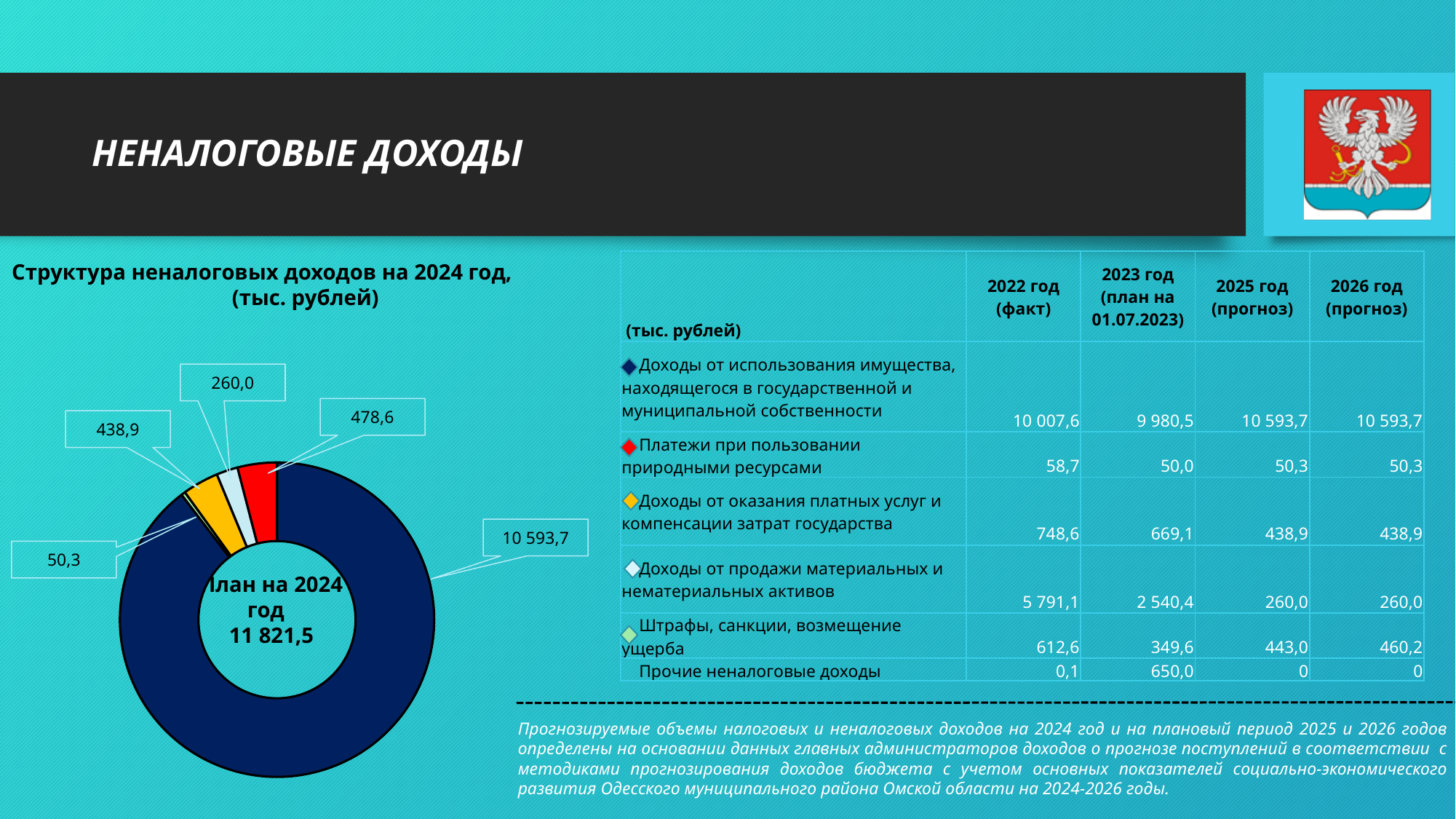
In the donut chart, what is the difference between the slices labelled 10 593,7 and 260,0? 10 333,7 In the donut chart, which is larger: the slice labelled 260,0 or the slice labelled 438,9? 438,9 What is the value of the largest slice in the donut chart? 10 593,7 How many slices does the donut chart have? 5 What share of the 11 821,5 total does the 10 593,7 slice represent in the donut chart? 89,6% What is the value of the smallest slice in the donut chart? 50,3 What total is printed in the centre of the donut chart for the 2024 plan? 11 821,5 What kind of chart is shown on the left of the slide? pie chart (donut) What is the combined value of the two smallest slices (50,3 and 260,0) in the donut chart? 310,3 In the donut chart, what is the difference between the slices labelled 478,6 and 438,9? 39,7 What is the title of the chart on the left? Структура неналоговых доходов на 2024 год, (тыс. рублей) What colour is the largest slice of the donut chart? dark blue